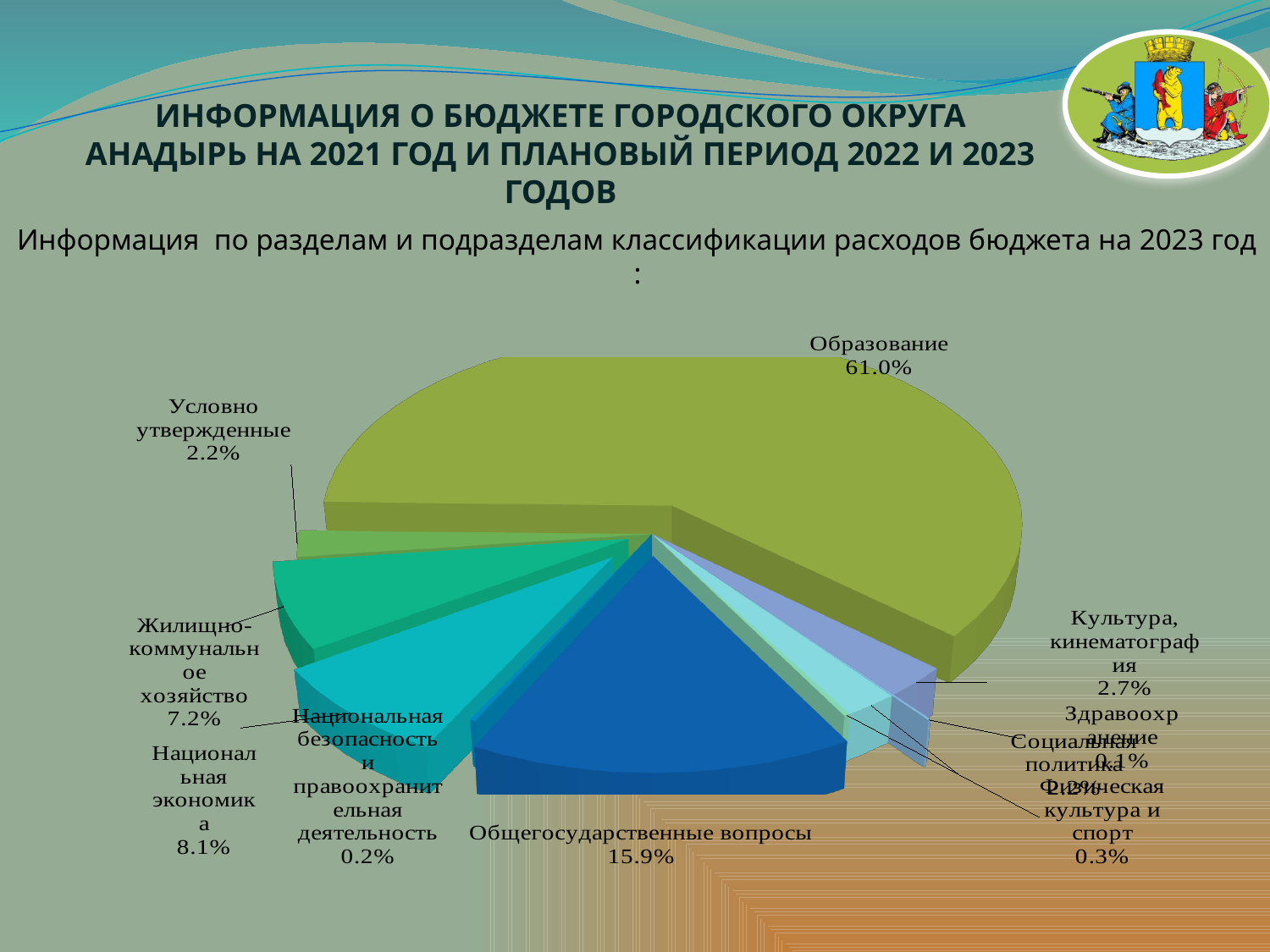
How many sections (slices) are shown in the pie chart? 10 Which section has the smallest share in the pie chart? Здравоохранение What is the share for Национальная экономика? 8.1% What share is shown for Культура, кинематография? 2.7% What share of the 2023 budget expenditure does Образование (Education) account for? 61.0% What percentage is given for Условно утвержденные? 2.2% Which section has the largest share of the 2023 budget expenditure? Образование What percentage is shown for Общегосударственные вопросы? 15.9% What percentage is labelled for Жилищно-коммунальное хозяйство? 7.2% What type of chart is used on the slide? Pie chart Which is larger: the share for Национальная экономика or for Жилищно-коммунальное хозяйство? Национальная экономика By how many percentage points does Образование exceed Общегосударственные вопросы? 45.1 percentage points